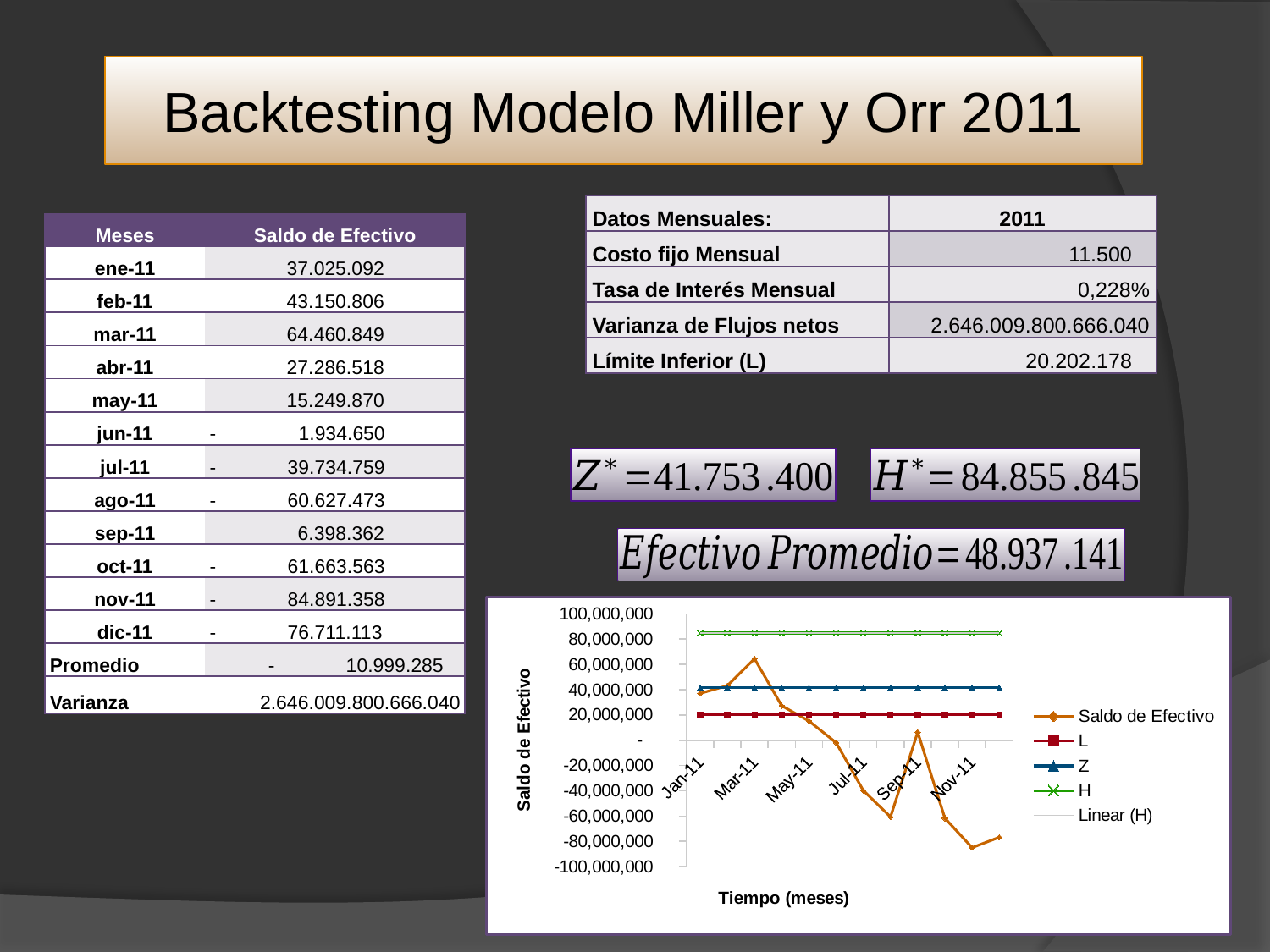
How many series does the chart legend list? 5 Is the value of the H series greater or less than 80,000,000? greater At which labelled month does the Saldo de Efectivo series reach its lowest value? Nov-11 Is the Saldo de Efectivo value at Nov-11 greater or less than -60,000,000? less What is the title of the vertical axis of the chart? Saldo de Efectivo Which series is plotted higher on the chart, H or Z? H What is the title of the horizontal axis of the chart? Tiempo (meses) Is the Saldo de Efectivo value at Jan-11 greater or less than 20,000,000? greater At which labelled month does the Saldo de Efectivo series reach its highest value? Mar-11 What kind of chart is shown on the slide? line chart Does the Saldo de Efectivo series rise or fall between Mar-11 and Jul-11? fall